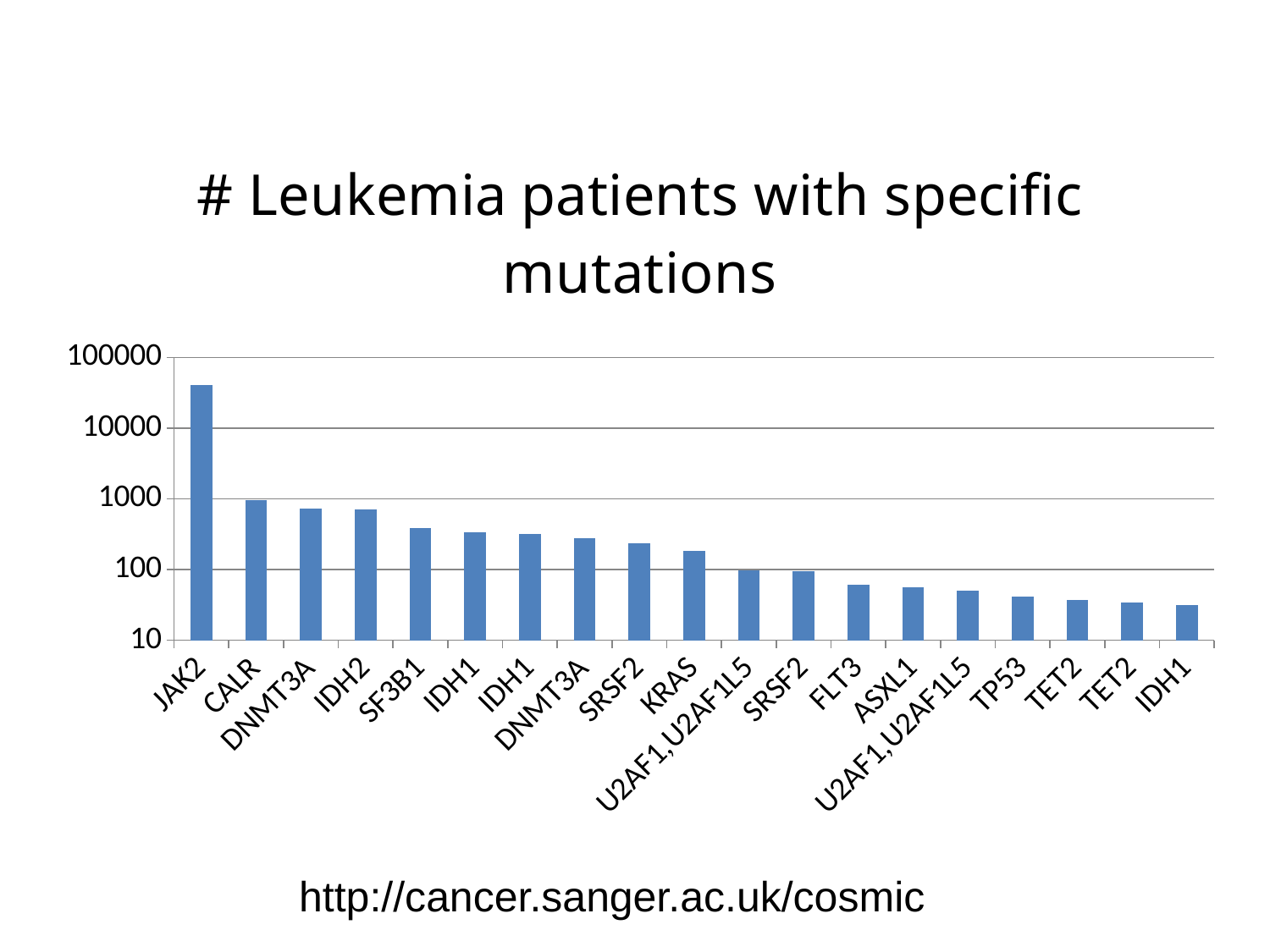
How many bars are plotted in the chart? 19 What is the title of the chart? # Leukemia patients with specific mutations Which has a larger value, JAK2 or CALR? JAK2 Is the value for JAK2 greater or less than 10000? greater Is the value for KRAS greater or less than 100? greater Is the value for FLT3 greater or less than 100? less What kind of chart is shown on the slide? bar chart Which has a larger value, KRAS or ASXL1? KRAS Which mutation has the highest number of leukemia patients? JAK2 Do the bar values rise or fall from left to right along the x axis? fall